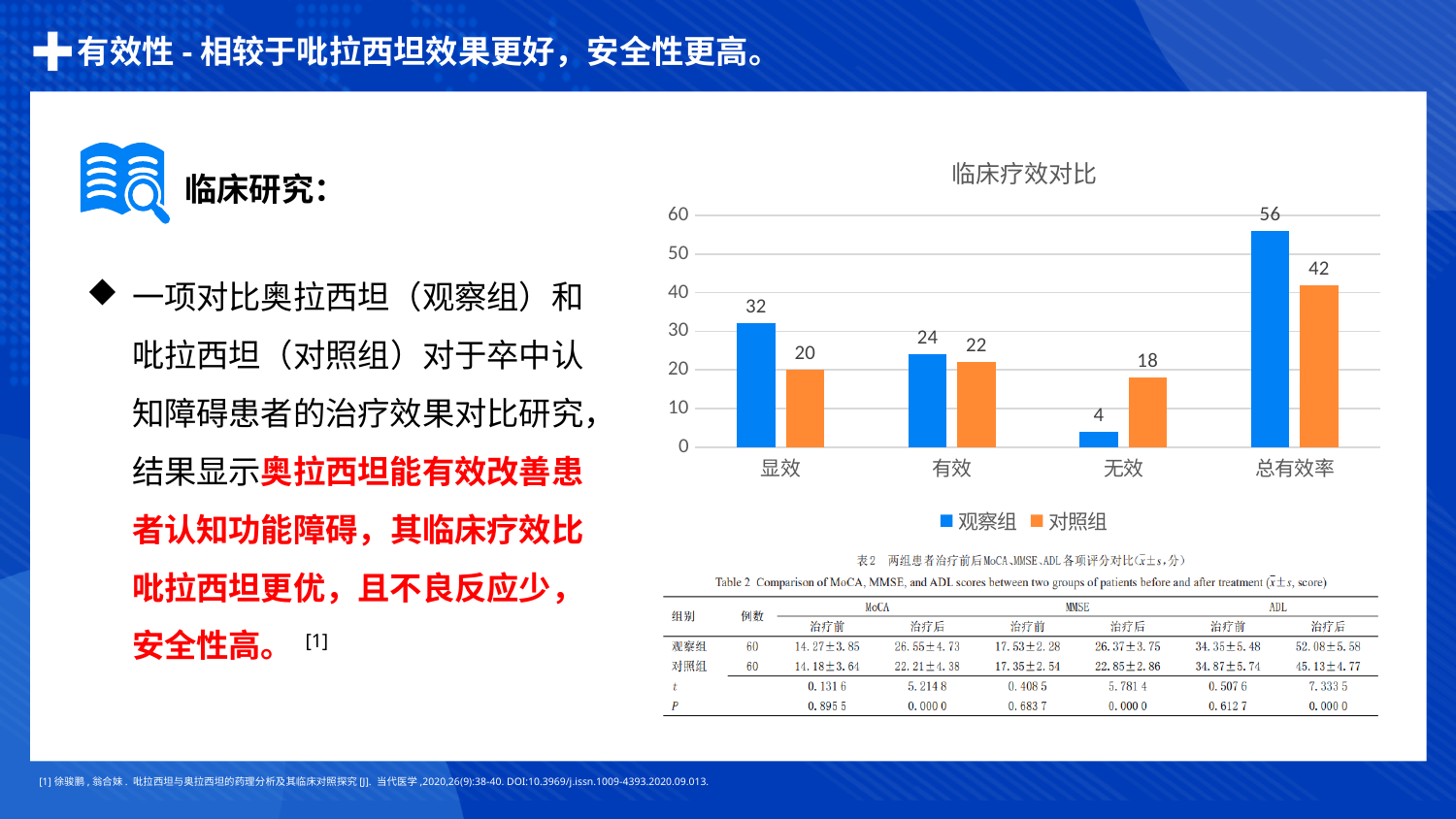
What kind of chart is shown on the slide? bar chart How many series does the chart legend list? 2 What is the title of the chart? 临床疗效对比 What is the value for 观察组 in the 无效 category? 4 Which category has the lowest value for 对照组? 无效 What is the difference between 观察组 and 对照组 in the 总有效率 category? 14 How many categories are shown on the x axis of the chart? 4 In the 无效 category, which series has the larger value, 观察组 or 对照组? 对照组 Which category has the highest value for 观察组? 总有效率 Is the value for 对照组 in the 有效 category greater or less than 30? less What is the value for 观察组 in the 显效 category? 32 What is the value for 对照组 in the 总有效率 category? 42